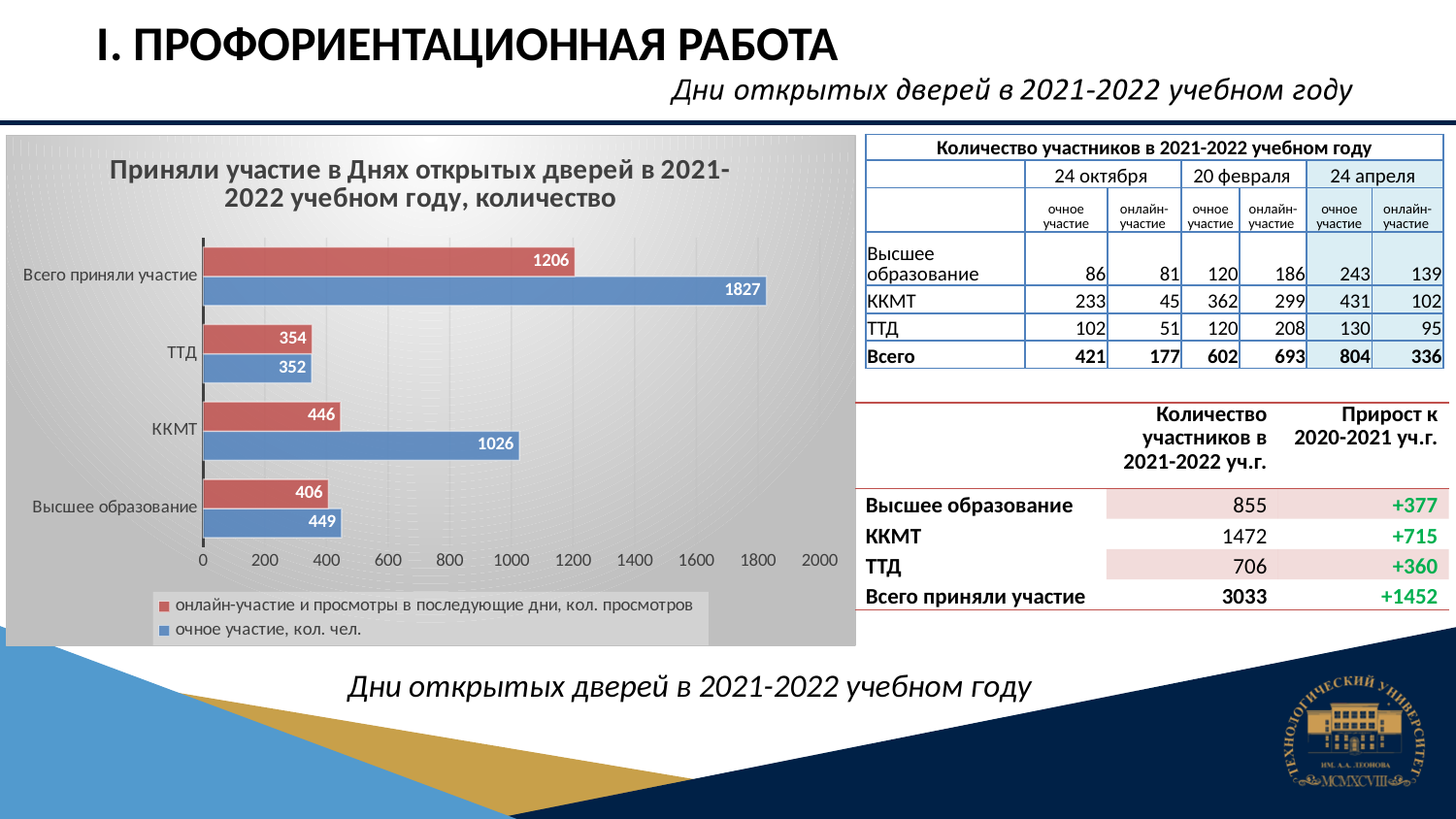
How many categories are shown on the chart's vertical axis? 4 What type of chart is shown on the slide? bar chart What is the title of the chart? Приняли участие в Днях открытых дверей в 2021-2022 учебном году, количество How many series does the chart legend list? 2 What is the value of 'онлайн-участие и просмотры в последующие дни, кол. просмотров' for Высшее образование? 406 What is the value of 'очное участие, кол. чел.' for 'Всего приняли участие'? 1827 For Высшее образование, which is larger: 'очное участие, кол. чел.' or 'онлайн-участие и просмотры в последующие дни, кол. просмотров'? очное участие, кол. чел. What is the difference between 'очное участие, кол. чел.' and 'онлайн-участие и просмотры в последующие дни, кол. просмотров' for ККМТ? 580 Excluding the 'Всего приняли участие' total, which category has the highest 'очное участие, кол. чел.' value? ККМТ What is the value of 'очное участие, кол. чел.' for ККМТ? 1026 Excluding the 'Всего приняли участие' total, which category has the lowest 'очное участие, кол. чел.' value? ТТД What is the value of 'онлайн-участие и просмотры в последующие дни, кол. просмотров' for ТТД? 354